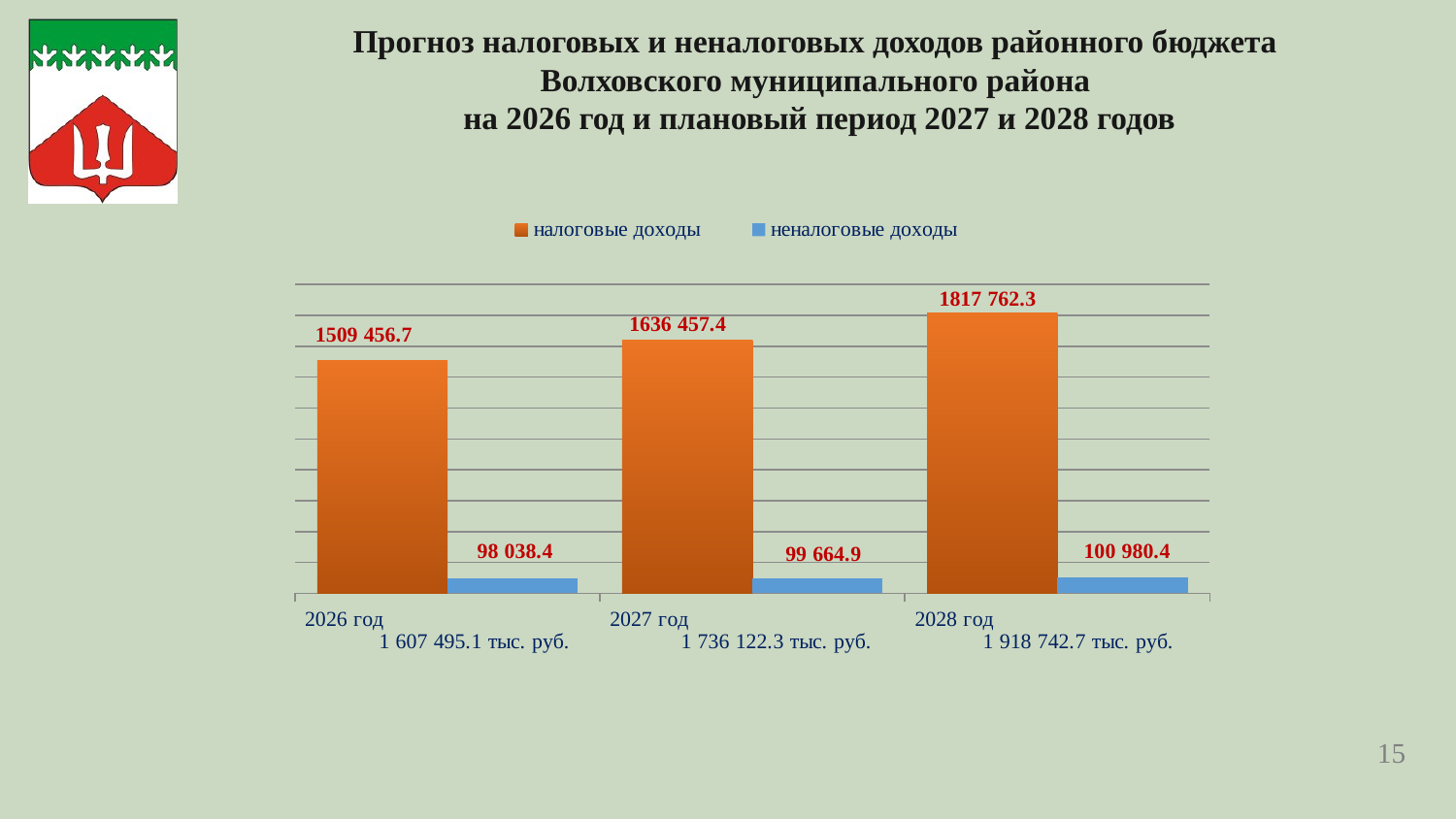
In which year are неналоговые доходы lowest? 2026 год Do налоговые доходы rise or fall from 2026 год to 2028 год? rise What total amount is shown under 2027 год? 1 736 122.3 тыс. руб. What is the value of налоговые доходы for 2028 год? 1817 762.3 What type of chart is shown on the slide? bar chart What is the value of налоговые доходы for 2026 год? 1509 456.7 How many years (categories) are shown on the x axis? 3 What is the difference between неналоговые доходы in 2028 год and 2026 год? 2 942.0 How many series does the legend list? 2 By how much do налоговые доходы in 2027 год exceed those in 2026 год? 127 000.7 In which year are налоговые доходы highest? 2028 год What is the value of неналоговые доходы for 2027 год? 99 664.9